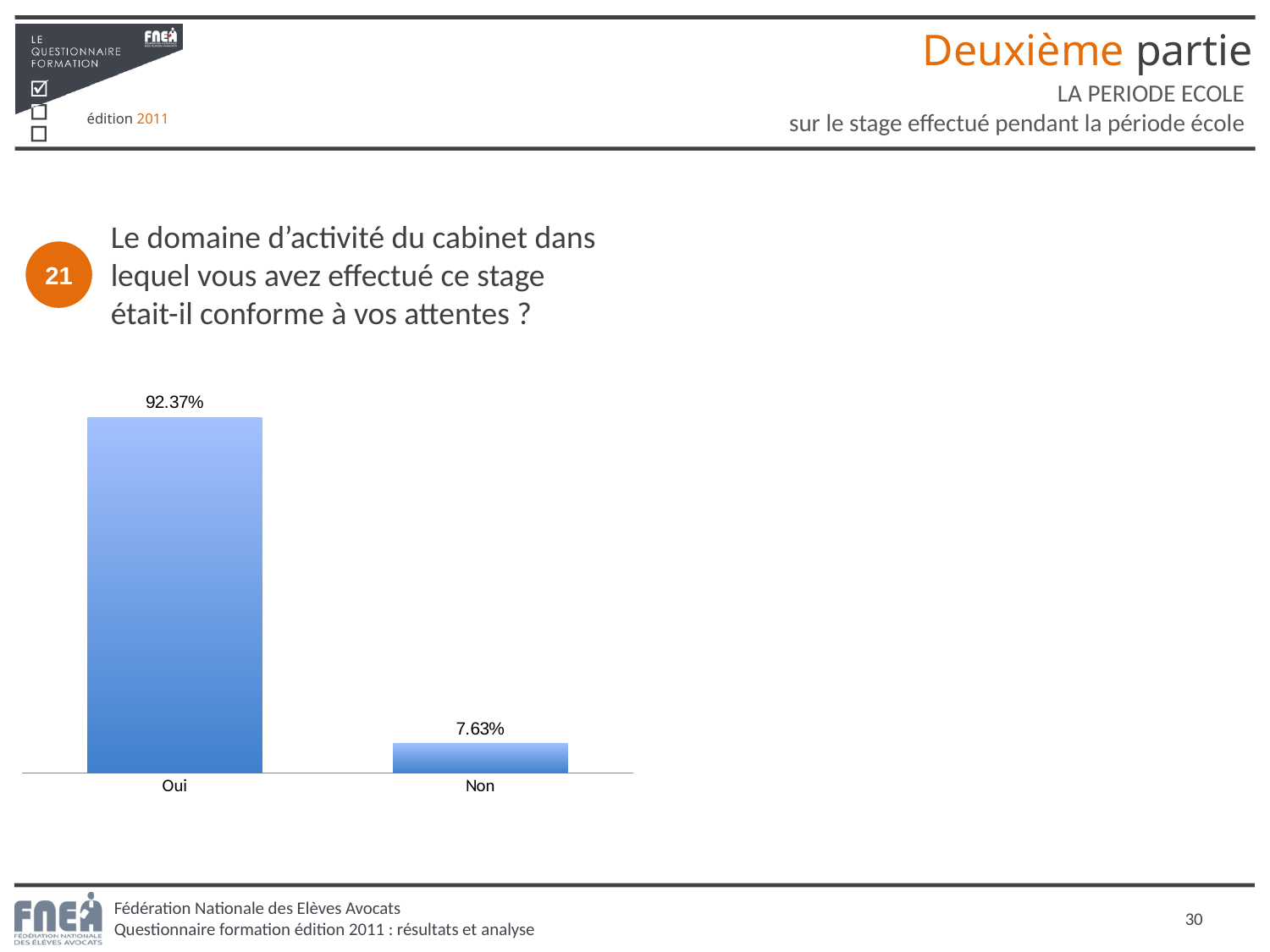
What kind of chart is shown on the slide? bar chart What colour are the bars in the chart? blue Which is larger, the value for Oui or the value for Non? Oui What is the value for Non? 7.63% What is the total of the two values shown in the chart? 100% What is the difference between the values for Oui and Non? 84.74% Which category has the lowest value? Non Which category has the highest value? Oui What is the number of the question shown next to the chart? 21 How many categories are shown in the chart? 2 What is the value for Oui? 92.37%